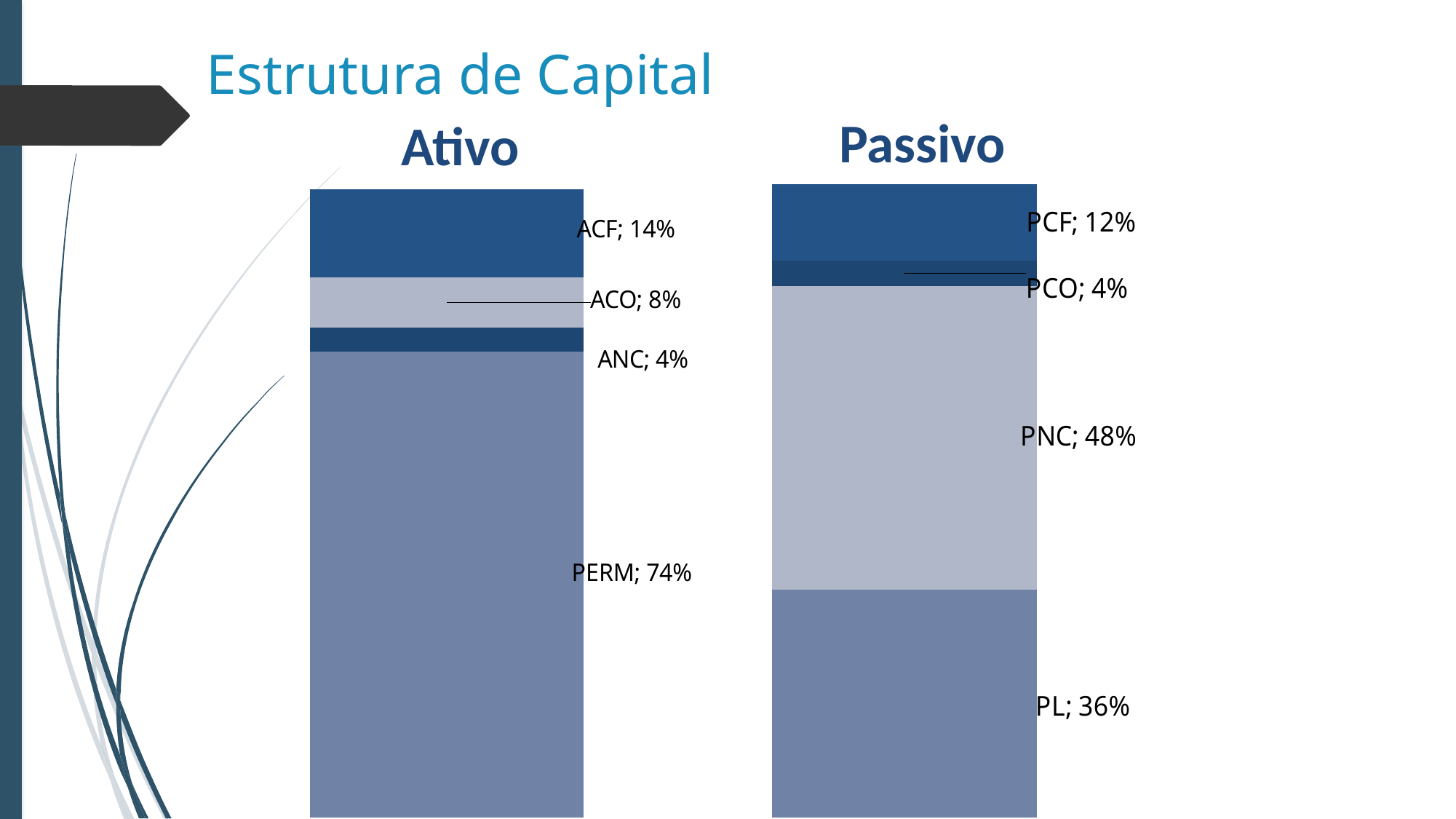
In the Passivo chart, which segment is the smallest? PCO In the Ativo chart, what is the difference between ACF and ANC? 10% What kind of chart is the Passivo chart? Stacked bar chart In the Ativo chart, which segment is the largest? PERM In the Passivo chart, which is larger, PCF or PCO? PCF In the Ativo chart, what is the value for PERM? 74% What is the total of the Passivo stacked bar? 100% In the Passivo chart, what is the difference between PNC and PL? 12% In the Passivo chart, what is the value for PL? 36% In the Passivo chart, what is the value for PNC? 48% How many segments does the Ativo bar have? 4 In the Ativo chart, what is the value for ACO? 8%